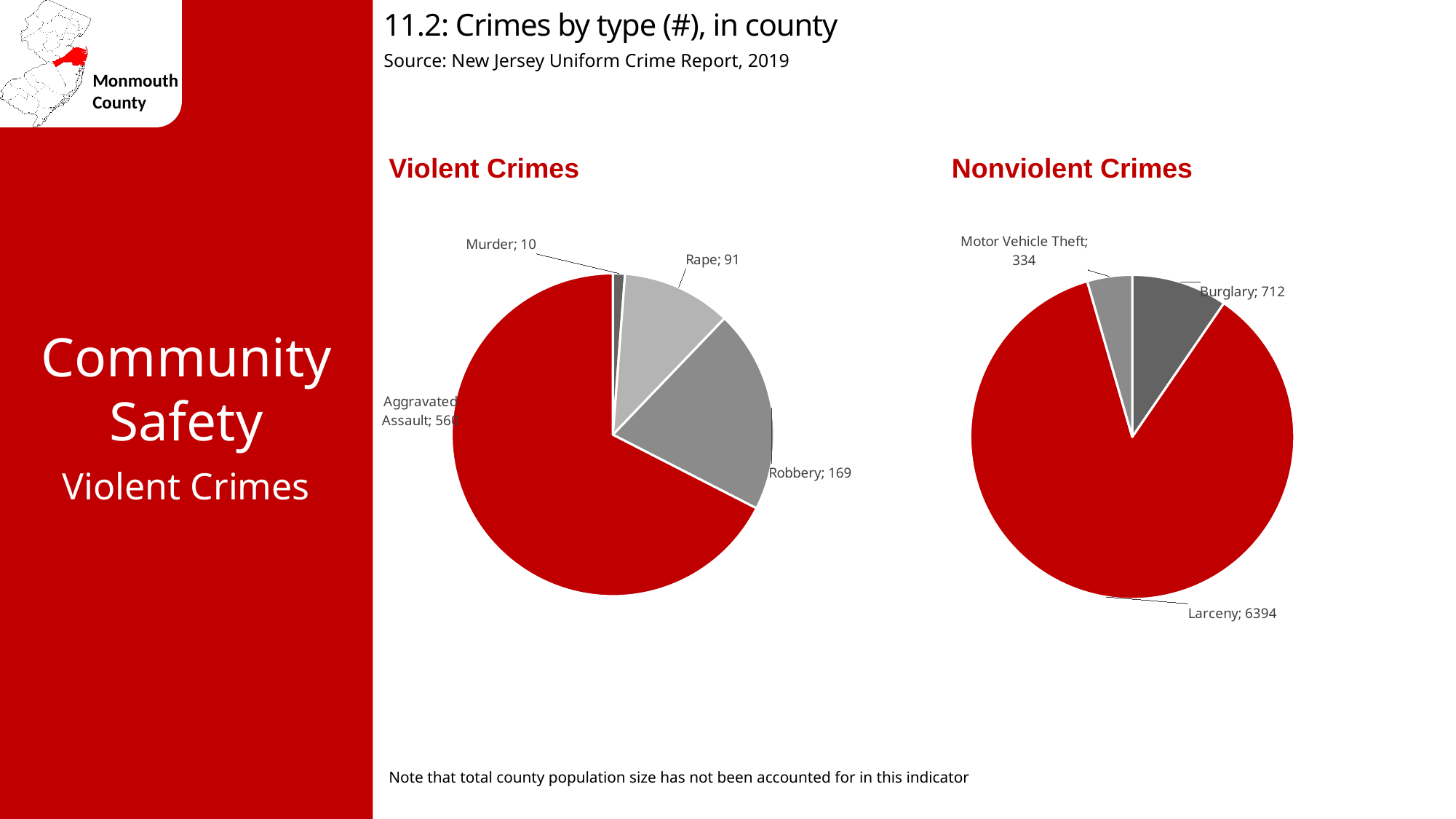
In the Nonviolent Crimes pie chart, what is the value for Larceny? 6394 In the Nonviolent Crimes pie chart, what is the value for Motor Vehicle Theft? 334 In the Nonviolent Crimes pie chart, what is the difference between Burglary and Motor Vehicle Theft? 378 In the Violent Crimes pie chart, which is larger, Robbery or Rape? Robbery In the Nonviolent Crimes pie chart, which crime type has the smallest slice? Motor Vehicle Theft In the Violent Crimes pie chart, what is the value for Rape? 91 In the Violent Crimes pie chart, how many murders are shown? 10 In the Violent Crimes pie chart, which crime type has the smallest slice? Murder How many categories does the Nonviolent Crimes pie chart show? 3 In the Violent Crimes pie chart, what is the value for Robbery? 169 In the Nonviolent Crimes pie chart, what is the value for Burglary? 712 In the Violent Crimes pie chart, which crime type has the largest slice? Aggravated Assault